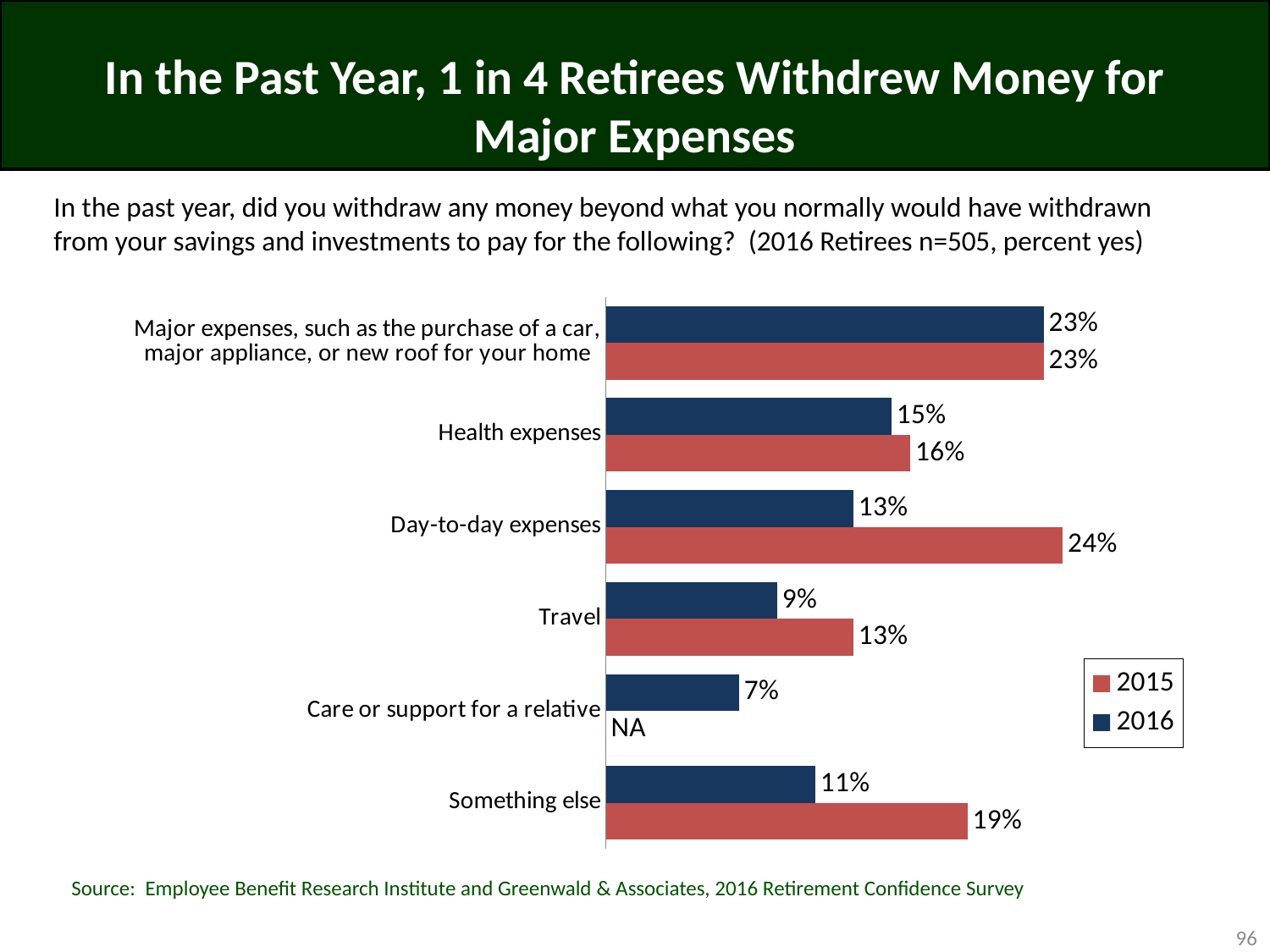
What is the 2015 value for 'Something else'? 19% How many series does the legend list? 2 What kind of chart is shown on the slide? Bar chart What percentage of retirees withdrew money for health expenses in 2016? 15% Which is larger for travel, the 2015 value or the 2016 value? 2015 How many categories are shown on the chart? 6 What is the 2016 value for travel? 9% What percentage of retirees withdrew money for day-to-day expenses in 2015? 24% What is the difference between the 2015 and 2016 values for day-to-day expenses? 11% Which category has the lowest 2016 value? Care or support for a relative Which category has the highest 2015 value? Day-to-day expenses What is shown in place of a 2015 value for 'Care or support for a relative'? NA